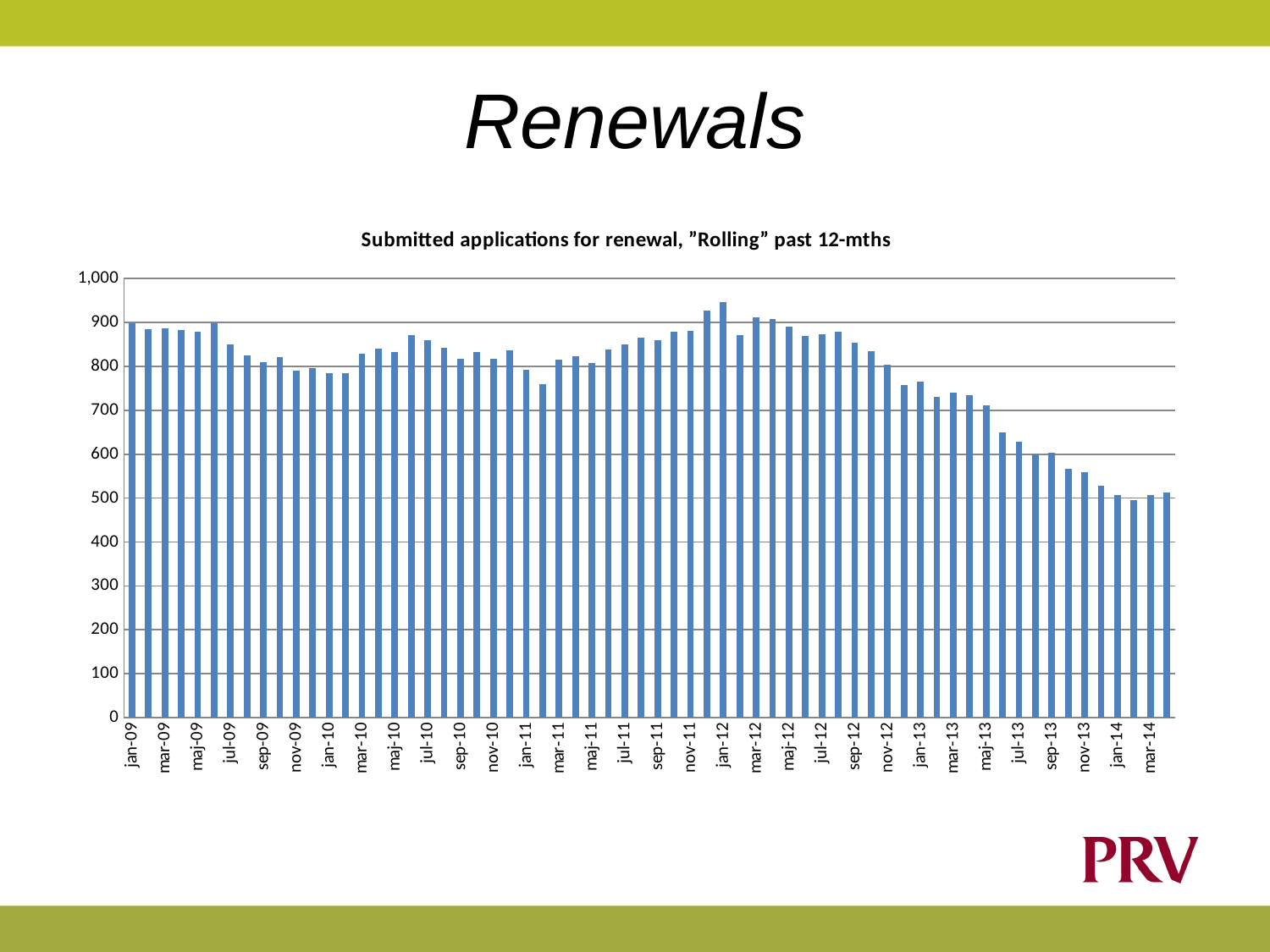
Is the value for jan-12 greater or less than 900? greater What is the title of the chart? Submitted applications for renewal, "Rolling" past 12-mths What is the highest value shown on the vertical axis? 1,000 Which is larger, the value for jul-09 or the value for jul-13? jul-09 Do the values rise or fall from jan-12 to mar-14? fall Which month has the highest value in the chart? jan-12 Is the value for jul-13 greater or less than 600? greater Is the value for jan-13 greater or less than 800? less Which is larger, the value for jan-12 or the value for mar-14? jan-12 What kind of chart is shown on the slide? bar chart